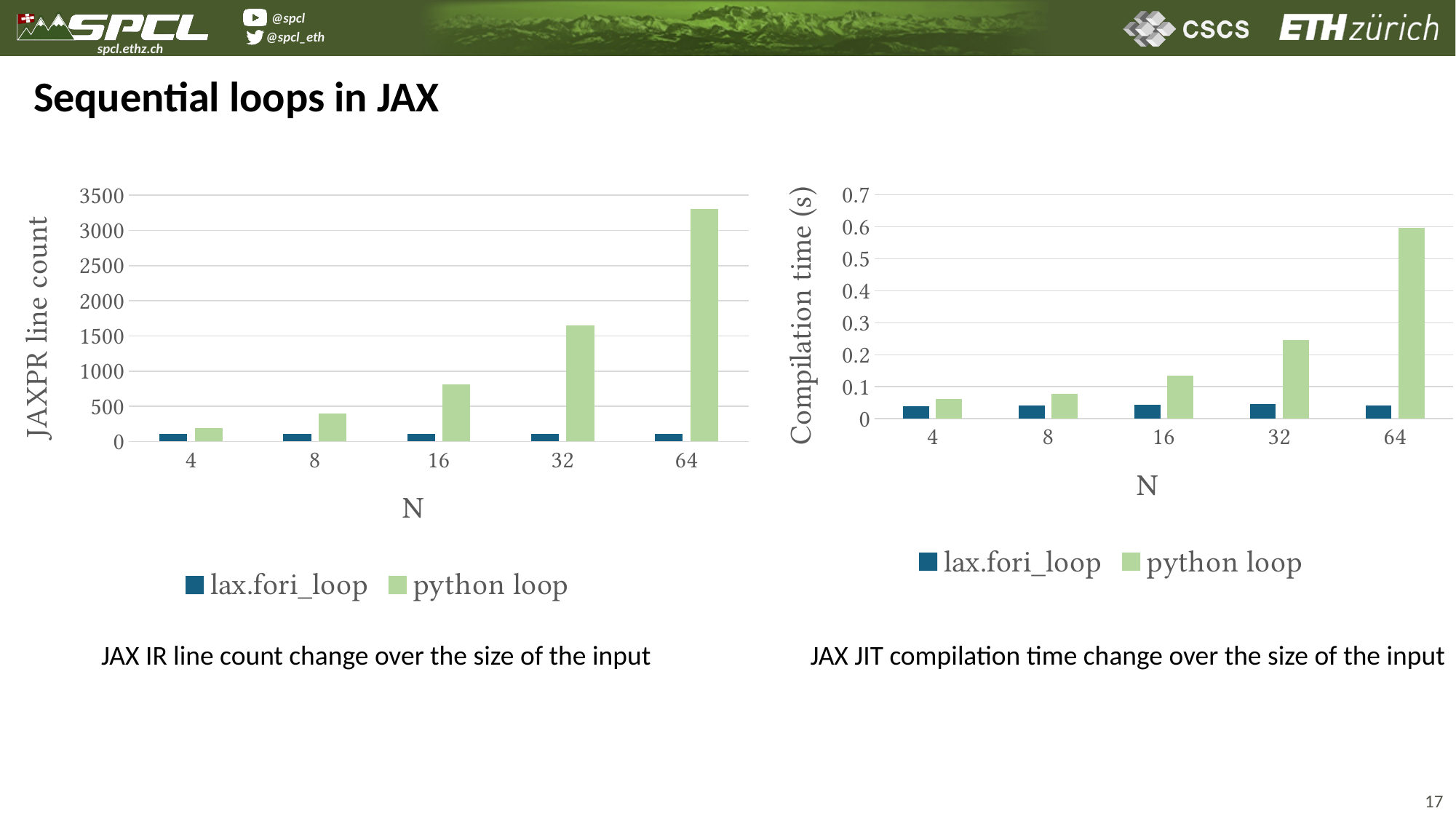
In the right chart (JAX JIT compilation time), what is the label of the y axis? Compilation time (s) In the left chart (JAX IR line count), at which N is the python loop bar highest? 64 In the left chart (JAX IR line count), is the python loop value for N = 16 greater or less than 1000? less In the left chart (JAX IR line count), is the lax.fori_loop value for N = 64 greater or less than 500? less In the left chart (JAX IR line count), what kind of chart is shown? bar chart In the right chart (JAX JIT compilation time), how many series does the legend list? 2 In the right chart (JAX JIT compilation time), is the lax.fori_loop value for N = 4 greater or less than 0.1? less In the left chart (JAX IR line count), do the python loop values rise or fall as N increases? rise In the right chart (JAX JIT compilation time), which series has the larger value at N = 32, lax.fori_loop or python loop? python loop In the left chart (JAX IR line count), how many N values are shown on the x axis? 5